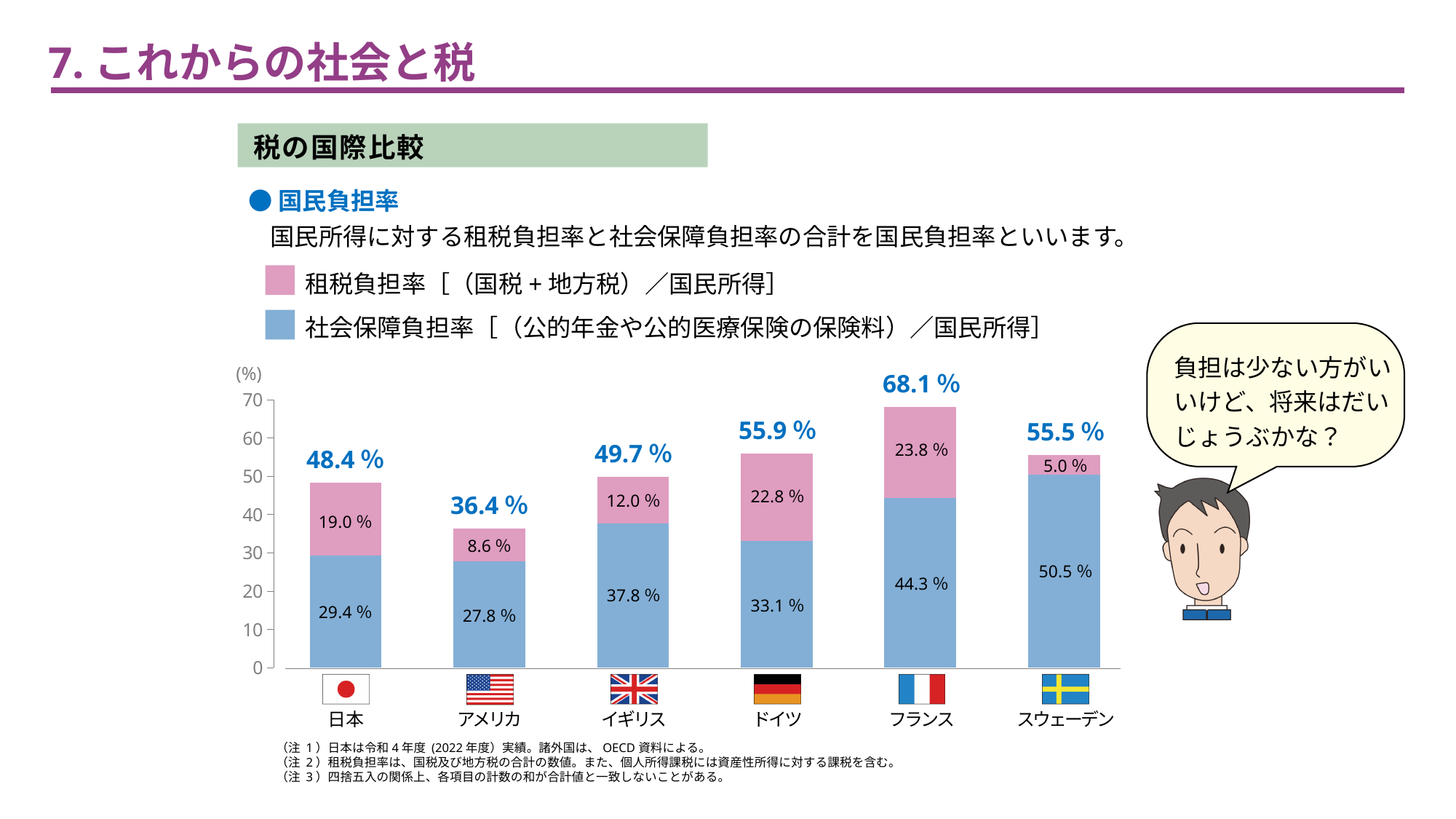
Is the total 国民負担率 for ドイツ greater or less than 50? greater Which country has the highest total 国民負担率 in the chart? フランス How many countries are shown in the chart? 6 Which country has the lowest total 国民負担率 in the chart? アメリカ What is the total 国民負担率 shown for 日本? 48.4 % How many series (segment types) does the legend list for the chart? 2 What is the 租税負担率 (pink segment) value for ドイツ? 22.8 % What kind of chart is used to show the 国民負担率 comparison? Stacked bar chart What is the 社会保障負担率 (blue segment) value for スウェーデン? 50.5 % What is the difference between the total 国民負担率 of フランス and 日本? 19.7 % Which is larger, the 租税負担率 of イギリス or of アメリカ? イギリス Which colour represents 社会保障負担率 in the chart? Blue